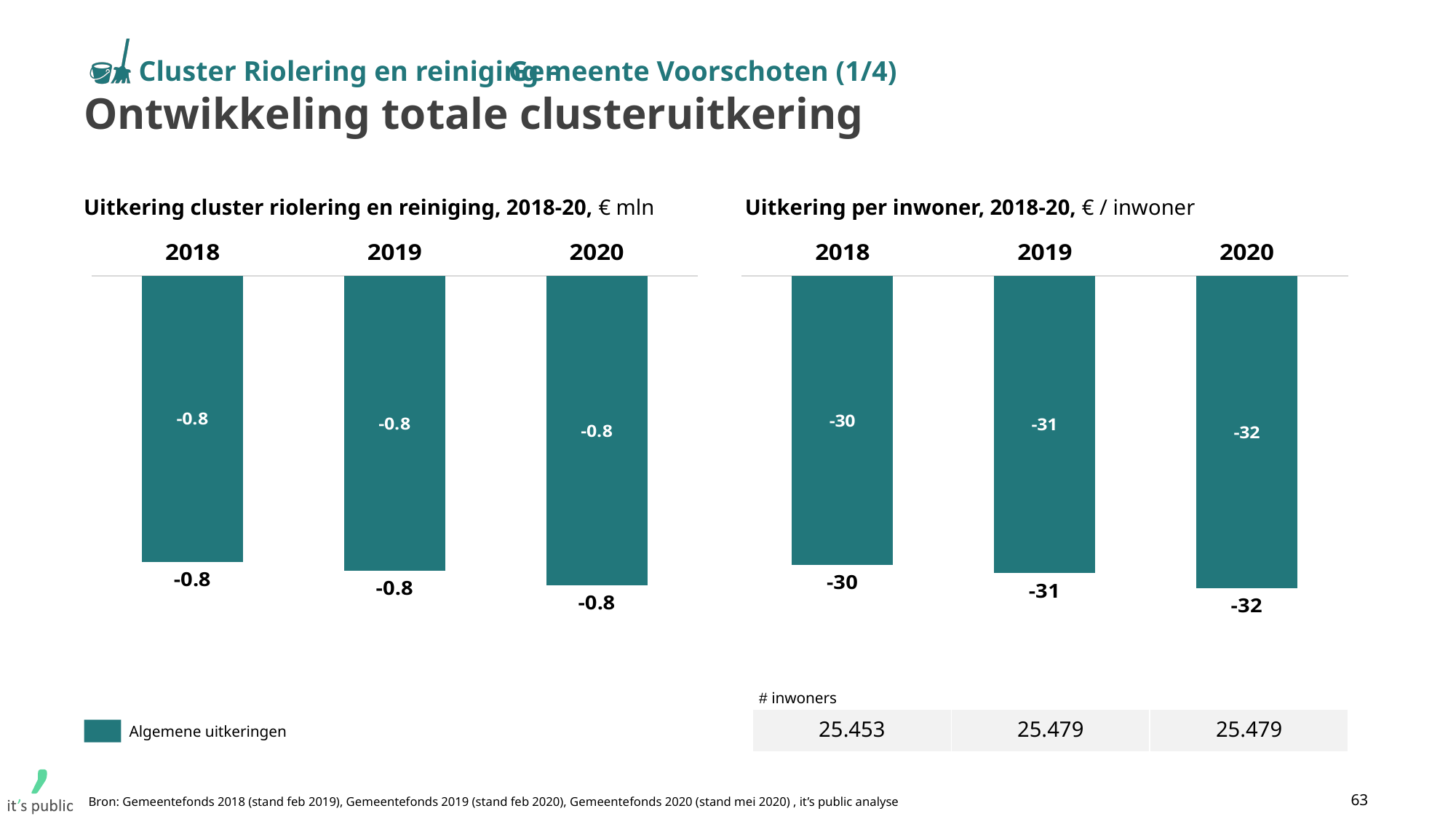
In the chart 'Uitkering per inwoner, 2018-20', is the value for 2019 larger or smaller than the value for 2020? larger What is the legend entry shown on the slide? Algemene uitkeringen How many years are shown in the chart 'Uitkering cluster riolering en reiniging, 2018-20'? 3 In the chart 'Uitkering per inwoner, 2018-20', what is the difference between the values for 2018 and 2020? 2 In the chart 'Uitkering per inwoner, 2018-20', what is the value for 2018? -30 In the chart 'Uitkering per inwoner, 2018-20', do the values rise or fall from 2018 to 2020? fall In the chart 'Uitkering cluster riolering en reiniging, 2018-20', what is the value for 2019? -0.8 In the chart 'Uitkering per inwoner, 2018-20', which year has the lowest value? 2020 How many series does the legend on the slide list? 1 In the chart 'Uitkering per inwoner, 2018-20', which year has the highest value? 2018 What kind of chart is 'Uitkering cluster riolering en reiniging, 2018-20'? bar chart In the chart 'Uitkering per inwoner, 2018-20', what is the value for 2020? -32